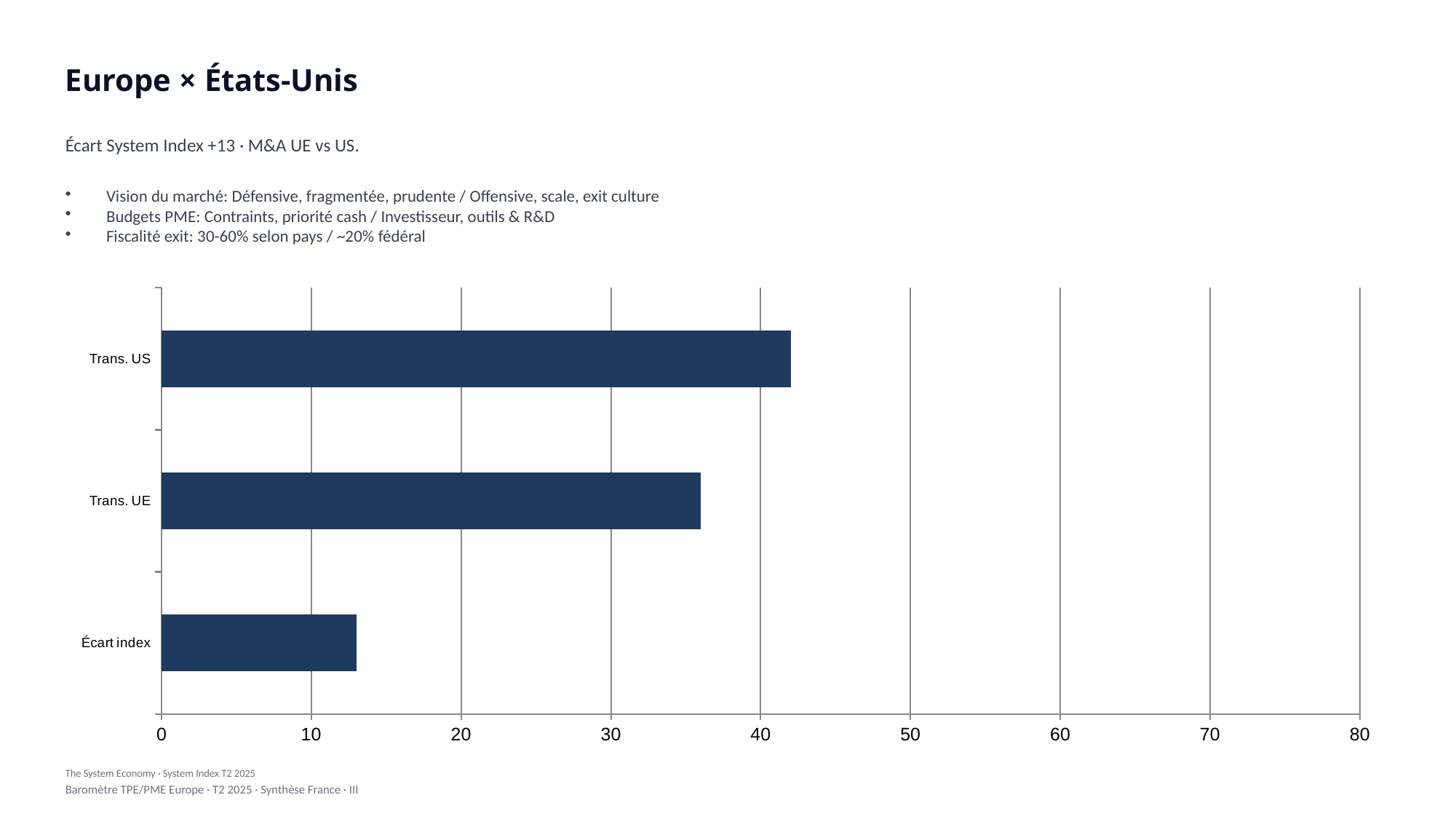
What is the maximum value shown on the horizontal axis? 80 Is the value for Trans. UE greater or less than 40? less Which category has the highest value? Trans. US Which is larger, the value for Trans. UE or the value for Écart index? Trans. UE Is the value for Trans. UE greater or less than 30? greater Which is larger, the value for Trans. US or the value for Trans. UE? Trans. US Is the value for Trans. US greater or less than 40? greater What is the title of the slide containing the chart? Europe × États-Unis How many categories does the chart show? 3 What kind of chart is shown on the slide? bar chart Which category has the lowest value? Écart index